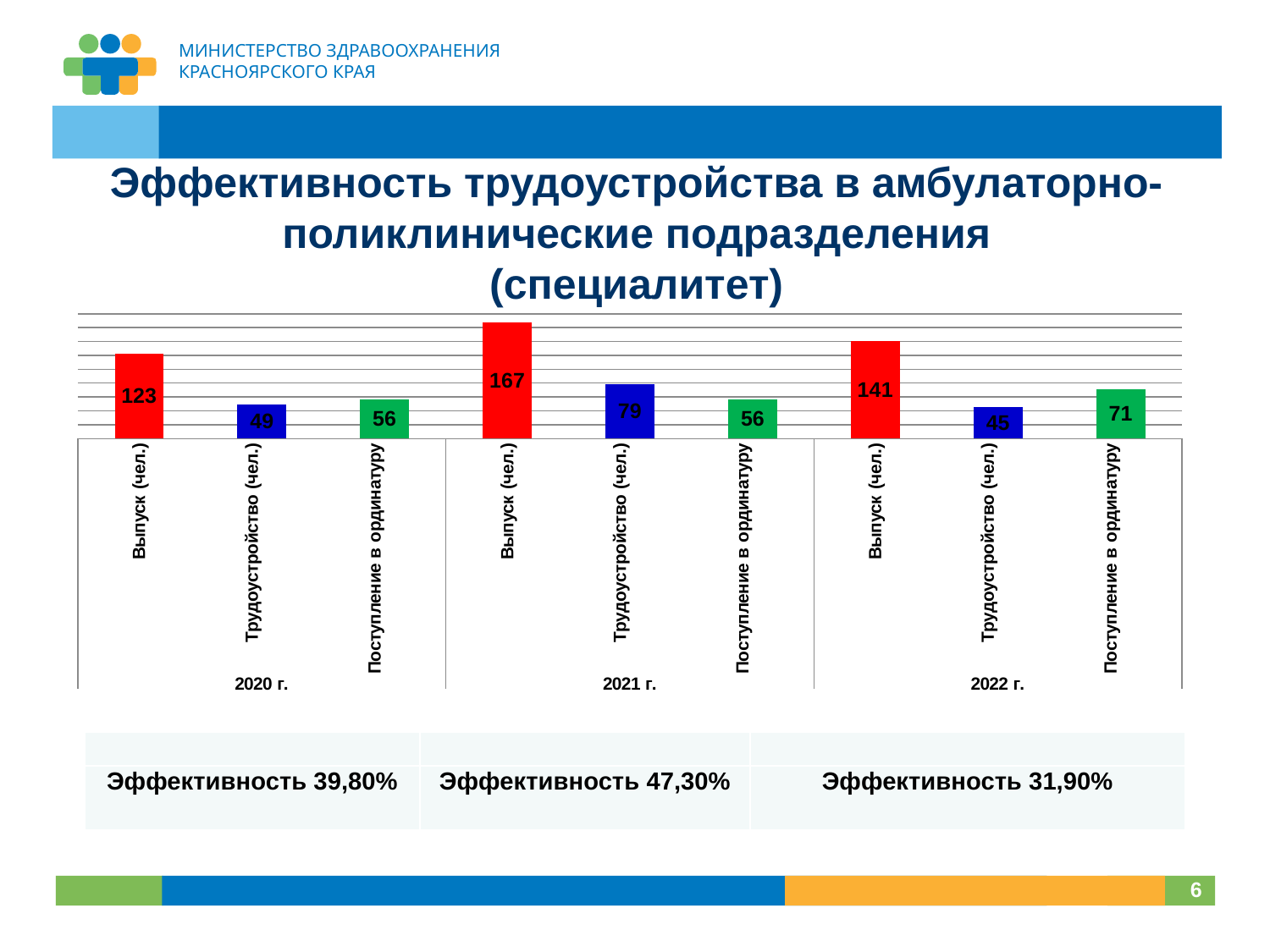
What kind of chart is shown on the slide? Bar chart What is the Эффективность value shown below the chart for 2021 г.? 47,30% Which year has the highest value for Выпуск (чел.)? 2021 г. What is the value for Трудоустройство (чел.) in 2021 г.? 79 What is the value for Выпуск (чел.) in 2020 г.? 123 How many bars are plotted on the chart? 9 What is the difference between Выпуск (чел.) and Трудоустройство (чел.) in 2021 г.? 88 What is the value for Трудоустройство (чел.) in 2022 г.? 45 Which bar has the lowest value on the chart? Трудоустройство (чел.) in 2022 г. What is the difference between Выпуск (чел.) in 2021 г. and Выпуск (чел.) in 2020 г.? 44 Which is larger: Поступление в ординатуру in 2022 г. or Поступление в ординатуру in 2020 г.? Поступление в ординатуру in 2022 г. What is the value for Поступление в ординатуру in 2022 г.? 71